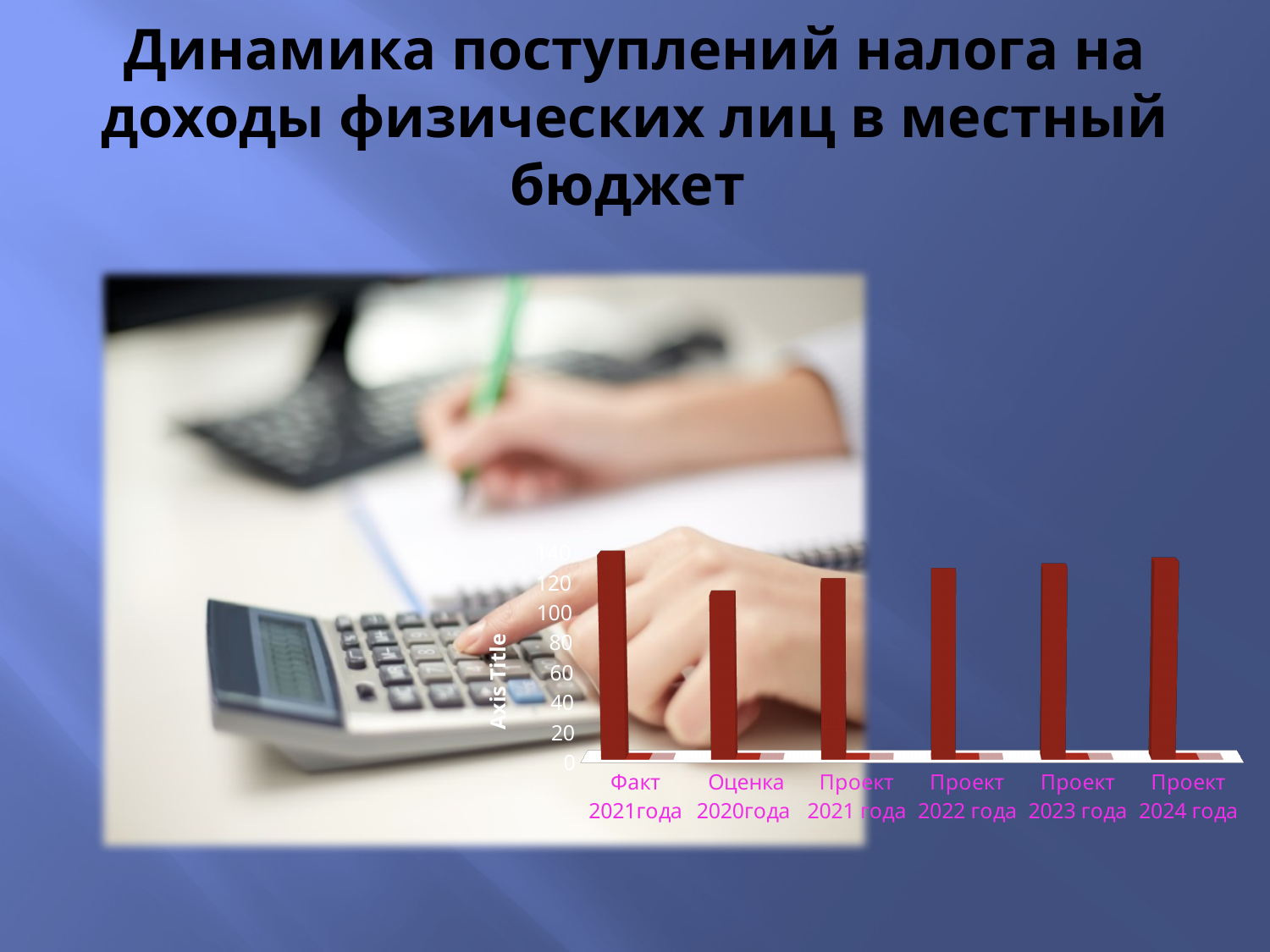
What kind of chart is shown on the slide? bar chart What is the highest tick value shown on the vertical axis? 140 Is the value for Оценка 2020года greater or less than 100? greater Is the value for Оценка 2020года greater or less than 120? less Which category has the lowest bar in the chart? Оценка 2020года Which is larger, the value for Проект 2021 года or the value for Проект 2023 года? Проект 2023 года How many categories (bars) does the chart show? 6 Do the values rise or fall from Проект 2021 года to Проект 2024 года? rise Which is larger, the value for Факт 2021года or the value for Оценка 2020года? Факт 2021года What is the title shown on the vertical axis of the chart? Axis Title Is the value for Проект 2022 года greater or less than 100? greater